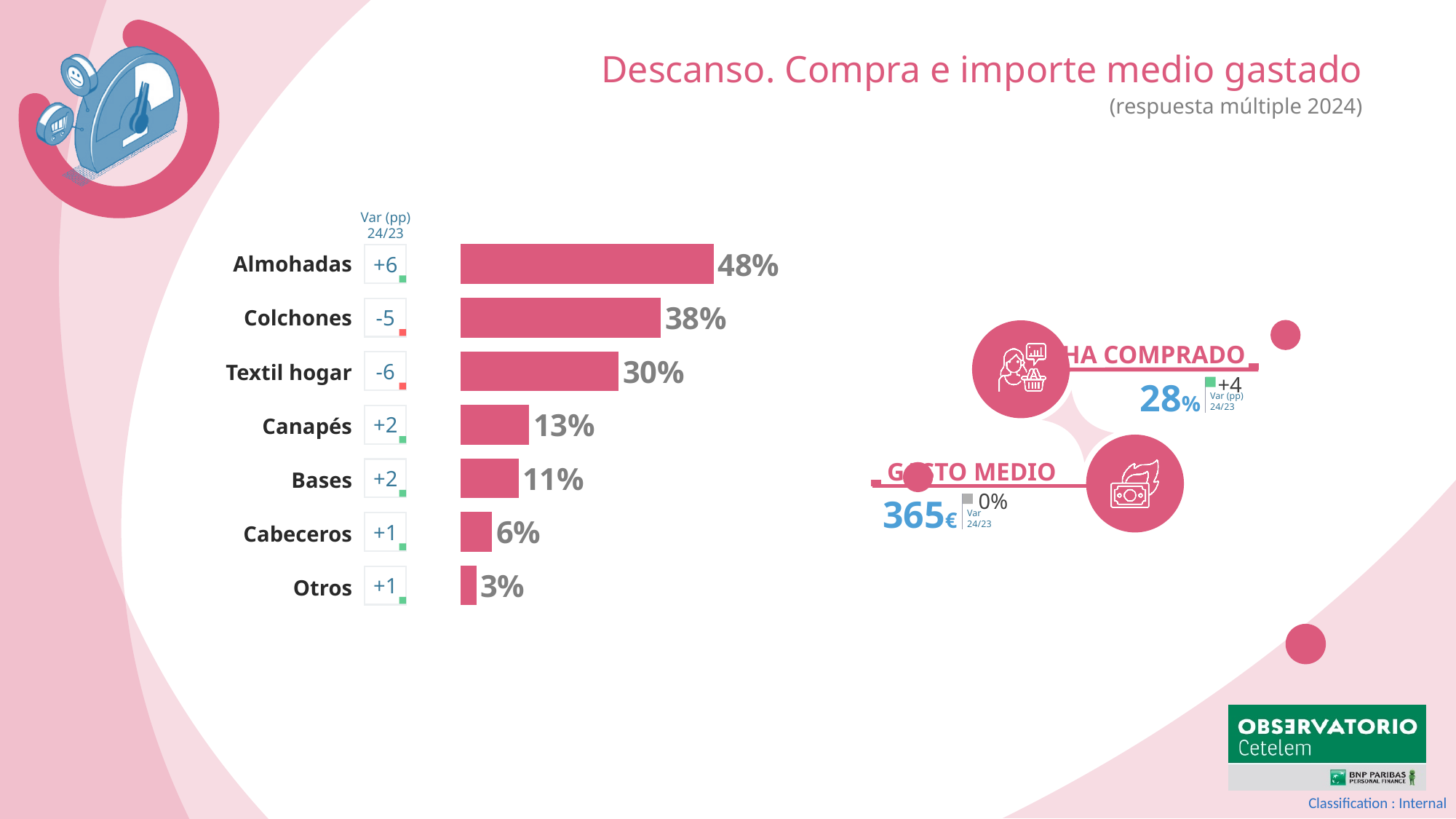
How many categories are shown in the bar chart? 7 What is the Var (pp) 24/23 value shown for Textil hogar? -6 Which category has the lowest percentage? Otros What percentage is shown for Colchones? 38% Which has a higher percentage, Canapés or Bases? Canapés Which category has the highest percentage? Almohadas What percentage is shown for Almohadas? 48% What kind of chart is used to show the purchase percentages? Bar chart What percentage is shown for Cabeceros? 6% What is the title of the slide? Descanso. Compra e importe medio gastado What percentage is shown for Textil hogar? 30% What is the difference in percentage points between Almohadas and Colchones? 10